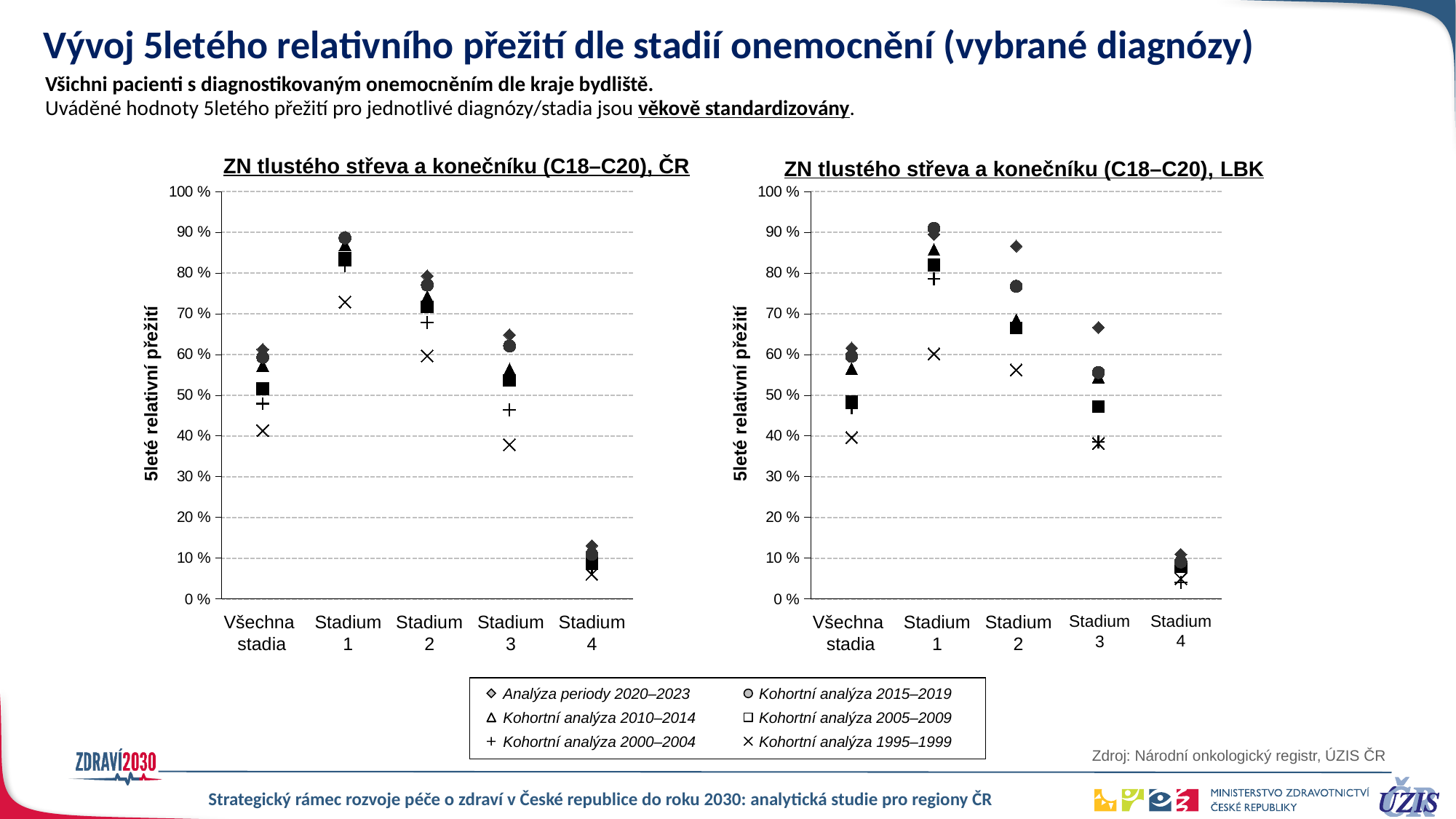
How many series does the shared legend list for the two charts? 6 How many categories are shown on the x axis of the right chart (LBK)? 5 In the ČR chart, is the value for Stadium 3 in Kohortní analýza 1995–1999 greater or less than 40 %? less What kind of chart is the left chart titled "ZN tlustého střeva a konečníku (C18–C20), ČR"? scatter chart In the LBK chart, is the value for Stadium 3 in Kohortní analýza 2005–2009 greater or less than 50 %? less In the ČR chart, do the values for Analýza periody 2020–2023 rise or fall from Stadium 1 to Stadium 4? fall What is the y-axis title of the right chart (LBK)? 5leté relativní přežití In the LBK chart, is the value for Stadium 2 in Analýza periody 2020–2023 greater or less than 80 %? greater In the ČR chart, which stage has the highest value for Analýza periody 2020–2023? Stadium 1 In the ČR chart, which stage has the lowest value for Analýza periody 2020–2023? Stadium 4 In the LBK chart, which is larger for Analýza periody 2020–2023: Stadium 1 or Stadium 4? Stadium 1